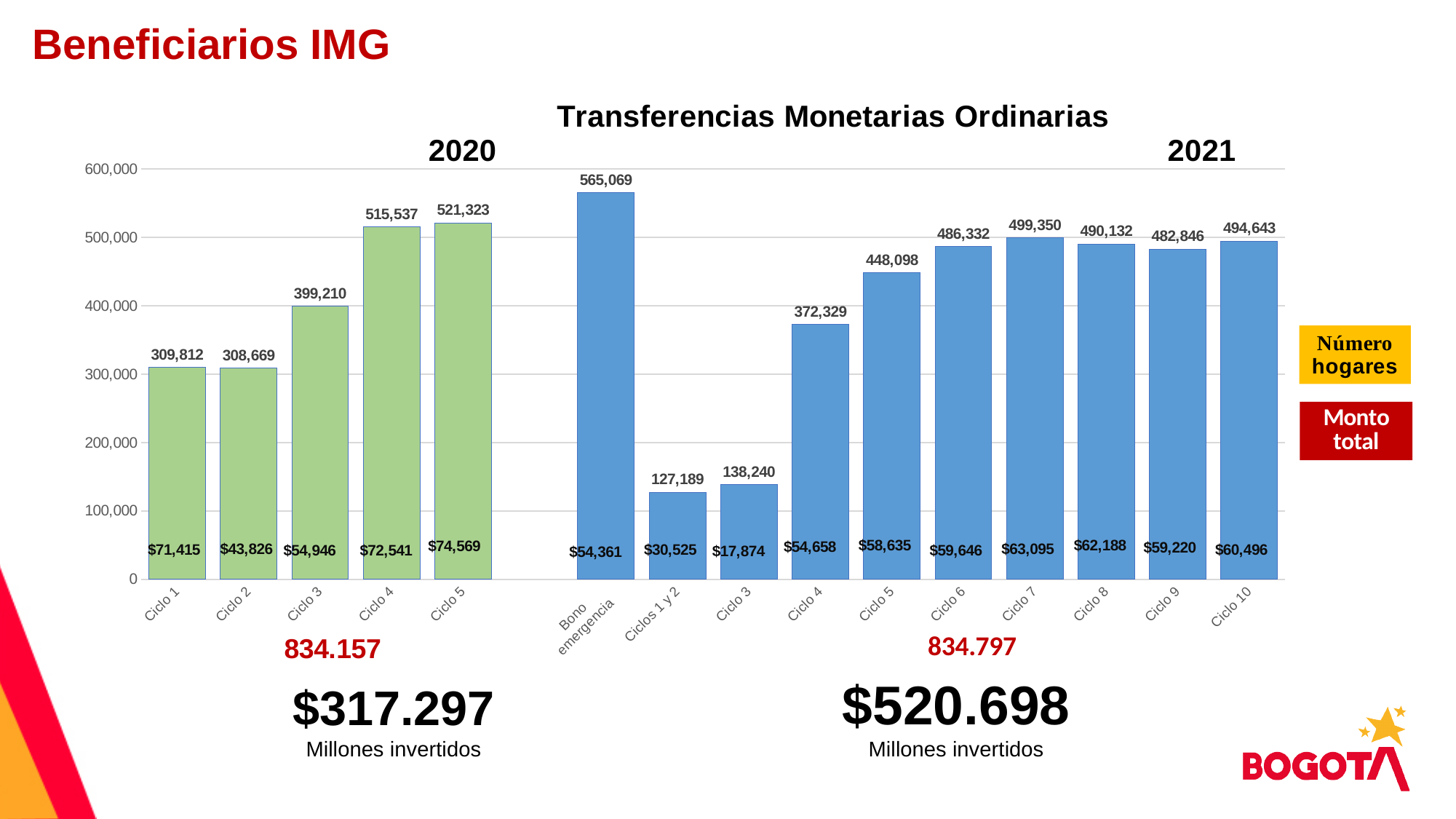
What is the number of households (Número hogares) shown for Ciclo 4 in 2020? 515,537 How many bars are shown for 2021? 10 What type of chart is shown on the slide? bar chart What is the number of households shown for the Bono emergencia bar in 2021? 565,069 Which bar has the lowest number of households in the chart? Ciclos 1 y 2 What is the Monto total label shown on the Ciclo 7 bar in 2021? $63,095 What is the Monto total label shown on the Ciclo 2 bar in 2020? $43,826 Which bar has the highest number of households in the chart? Bono emergencia What is the difference in number of households between Ciclo 5 and Ciclo 4 in 2020? 5,786 Which has more households: Ciclo 3 in 2020 or Ciclo 4 in 2021? Ciclo 3 in 2020 Do the number of households values rise or fall from Ciclo 1 to Ciclo 5 in 2020? rise Is the number of households for Ciclo 6 in 2021 greater or less than 400,000? greater